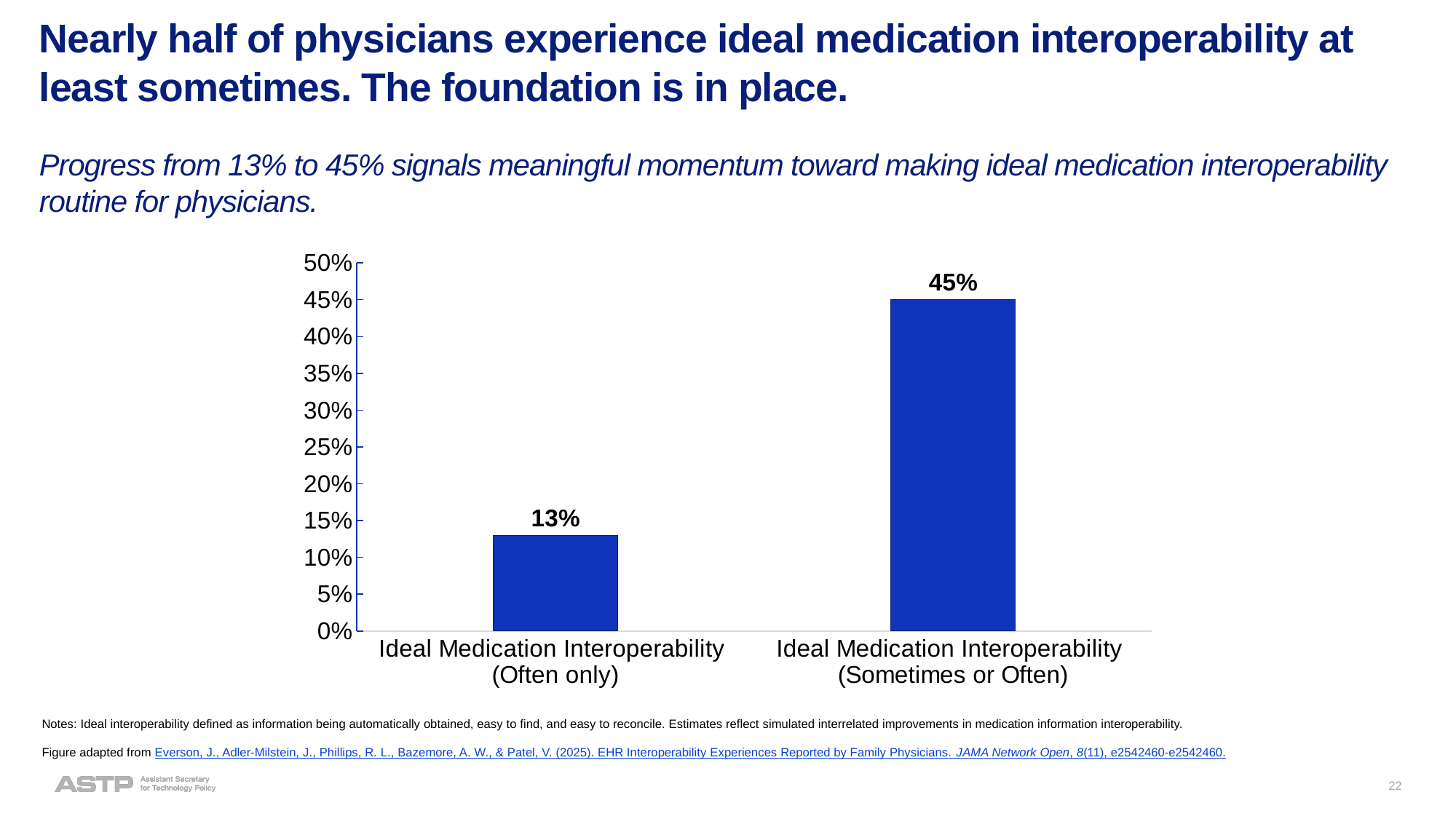
What is the value for Ideal Medication Interoperability (Often only)? 13% What is the value for Ideal Medication Interoperability (Sometimes or Often)? 45% Is the value for Ideal Medication Interoperability (Sometimes or Often) greater or less than 40%? greater Which category has the lowest value? Ideal Medication Interoperability (Often only) Is the value for Ideal Medication Interoperability (Often only) greater or less than 20%? less What is the maximum value shown on the vertical axis of the chart? 50% What colour are the bars in the chart? Blue How many categories are shown in the chart? 2 What kind of chart is shown on the slide? Bar chart Which category has the highest value? Ideal Medication Interoperability (Sometimes or Often) Which is larger: the value for Ideal Medication Interoperability (Often only) or the value for Ideal Medication Interoperability (Sometimes or Often)? Ideal Medication Interoperability (Sometimes or Often) What is the difference between the values for Ideal Medication Interoperability (Sometimes or Often) and Ideal Medication Interoperability (Often only)? 32%